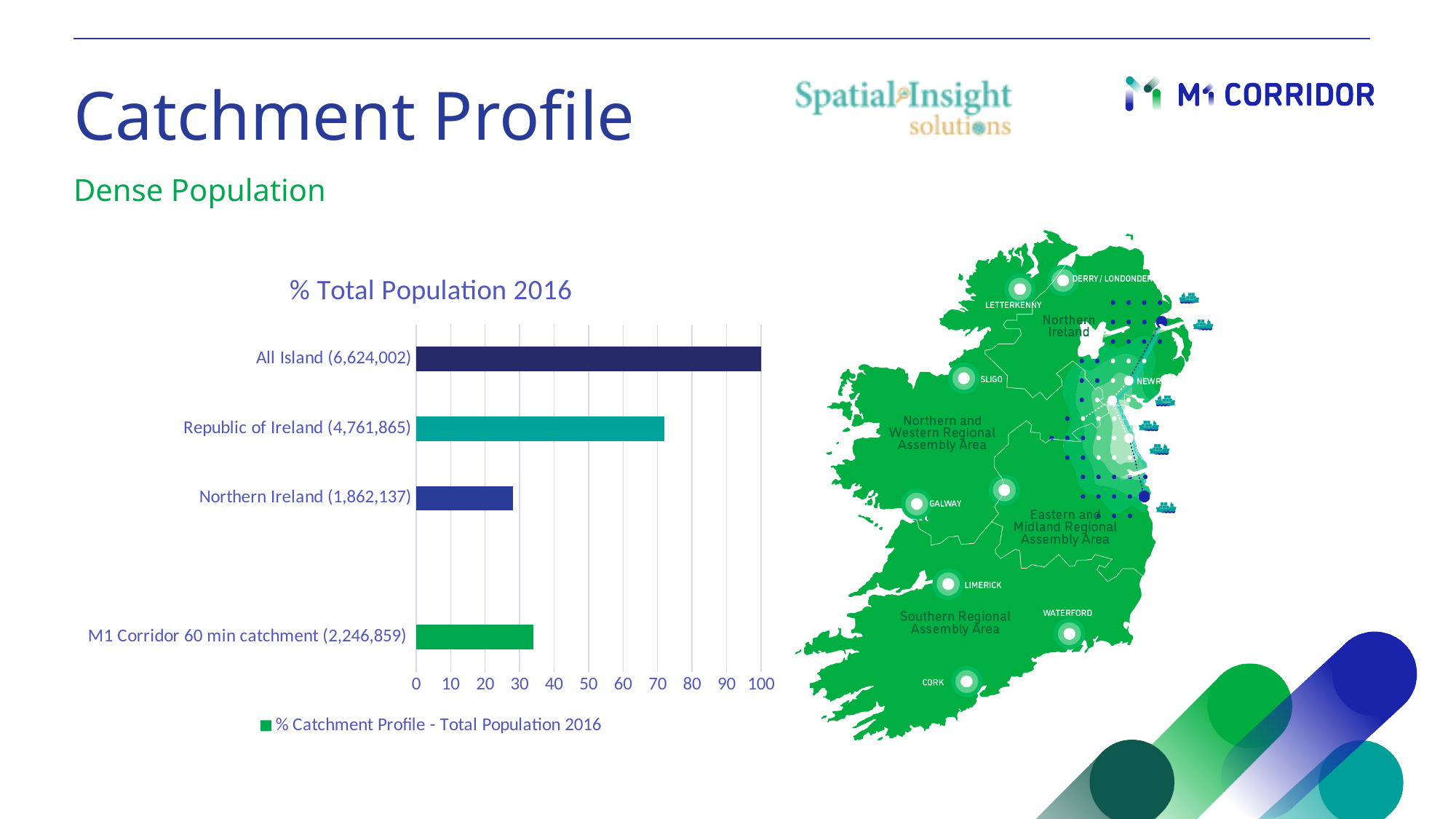
How many series does the legend of the "% Total Population 2016" chart list? 1 What is the title of the bar chart on the slide? % Total Population 2016 Is the value for Republic of Ireland (4,761,865) greater or less than 60? greater How many categories are plotted in the "% Total Population 2016" chart? 4 What kind of chart is shown under the title "% Total Population 2016"? bar chart Which category has the lowest value in the "% Total Population 2016" chart? Northern Ireland (1,862,137) Is the value for M1 Corridor 60 min catchment (2,246,859) greater or less than 30? greater Is the value for Northern Ireland (1,862,137) greater or less than 40? less Which category has the highest value in the "% Total Population 2016" chart? All Island (6,624,002) Which is larger, the value for M1 Corridor 60 min catchment (2,246,859) or the value for Northern Ireland (1,862,137)? M1 Corridor 60 min catchment (2,246,859) What is the legend entry shown below the bar chart? % Catchment Profile - Total Population 2016 What value does the bar for All Island (6,624,002) reach on the x axis? 100